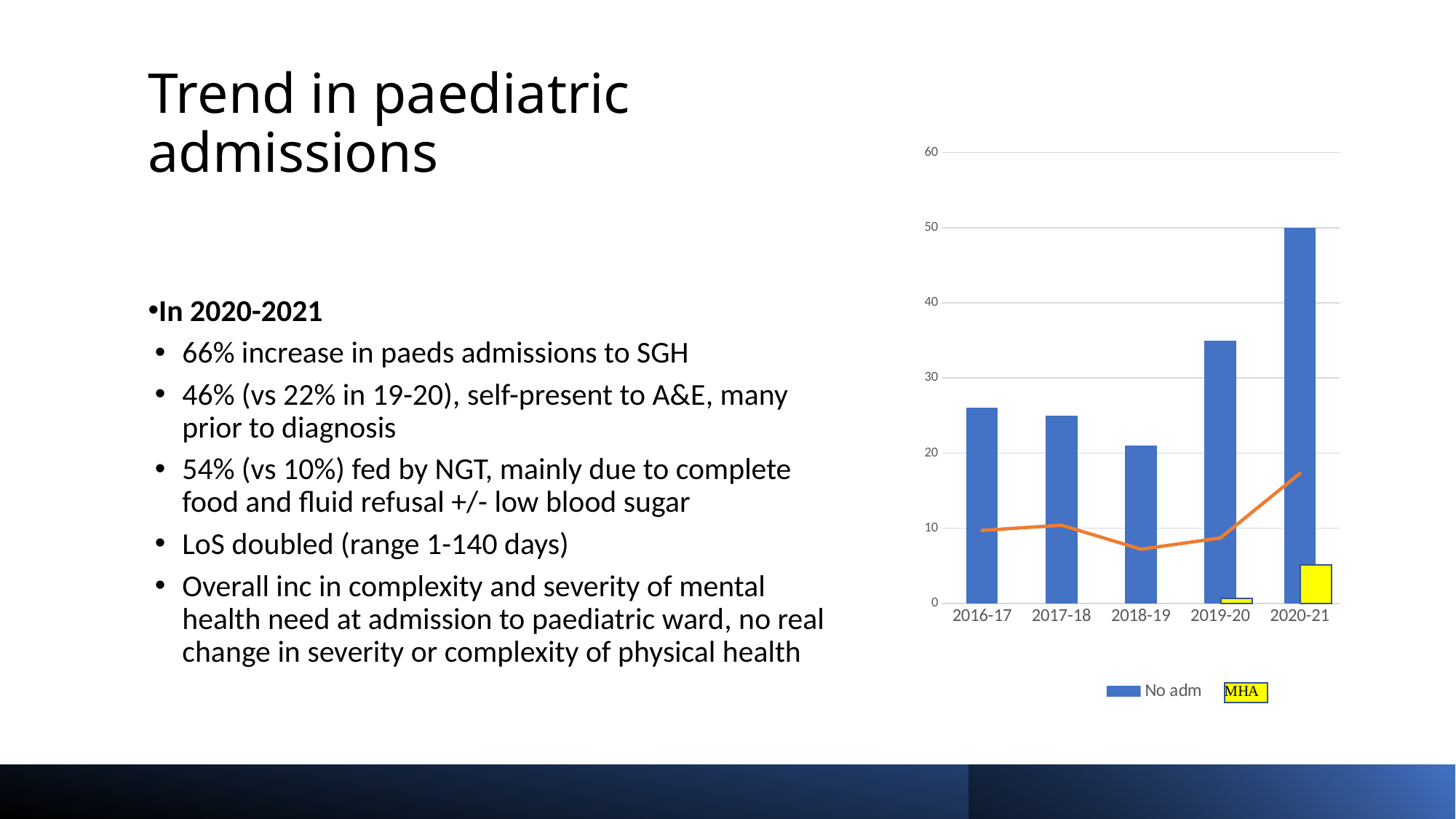
Is the No adm value for 2018-19 greater or less than 30? less How many series does the chart's legend list? 2 What are the two entries listed in the chart's legend? No adm, MHA What kind of chart is shown on the slide? combination bar and line chart Which year has the lowest value for No adm? 2018-19 Which year has the highest value for No adm? 2020-21 Is the No adm value for 2019-20 greater or less than 30? greater Do the No adm values rise or fall from 2018-19 to 2020-21? rise Is the No adm value for 2020-21 greater or less than 40? greater How many year categories are shown on the x axis of the chart? 5 Which year has a larger No adm value, 2017-18 or 2019-20? 2019-20 How many years show a visible MHA bar? 2